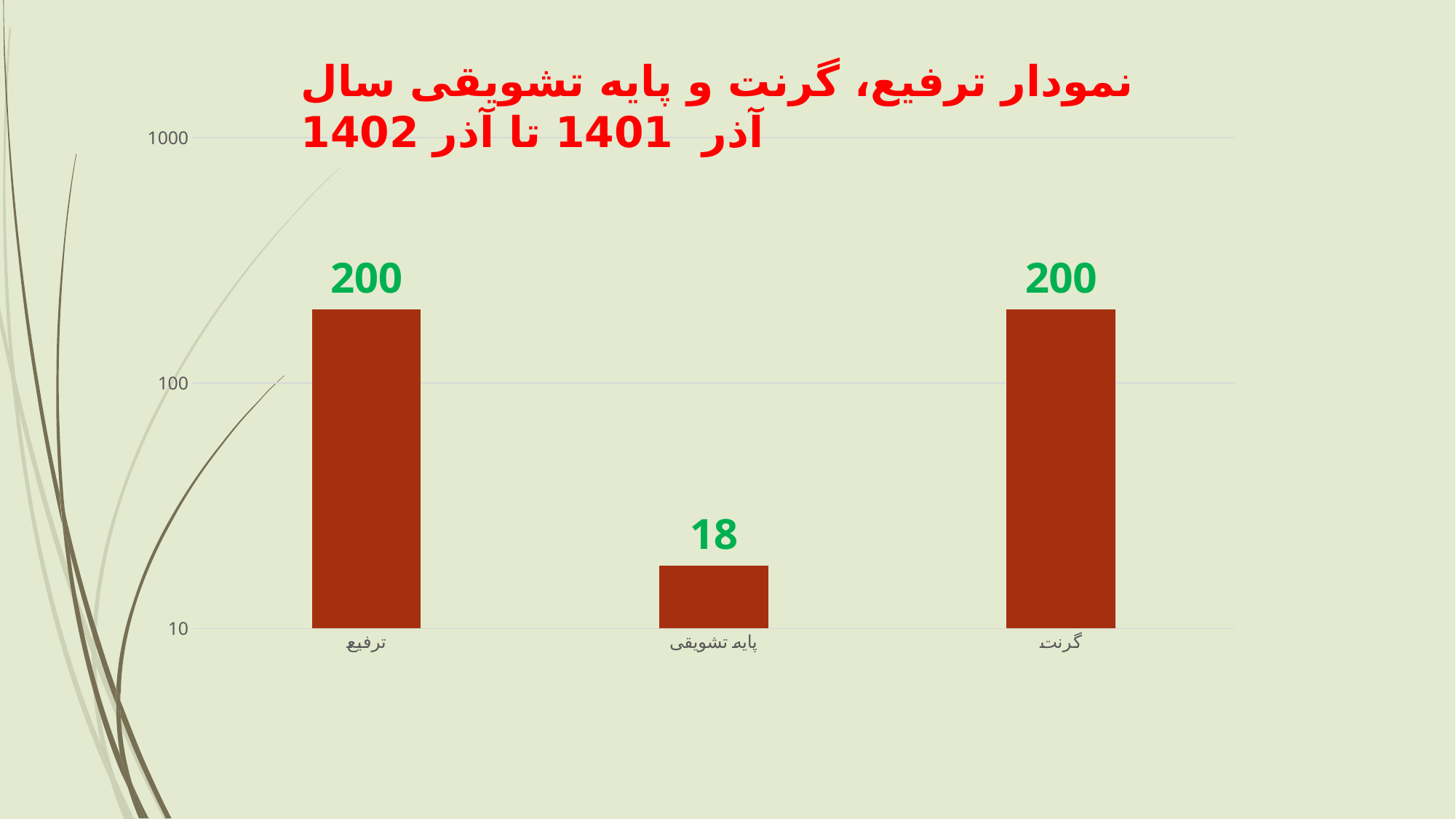
Is the value for پایه تشویقی greater or less than 100? less Which is larger, the value for ترفیع or the value for پایه تشویقی? ترفیع How many categories are shown in the chart? 3 What is the value for گرنت? 200 What is the value for ترفیع? 200 Is the value for گرنت greater or less than 100? greater What is the difference between the value for گرنت and the value for پایه تشویقی? 182 What is the value for پایه تشویقی? 18 What colour are the bars in the chart? red-brown What kind of chart is shown on the slide? bar chart Which category has the lowest value? پایه تشویقی What is the title of the chart? نمودار ترفیع، گرنت و پایه تشویقی سال آذر 1401 تا آذر 1402